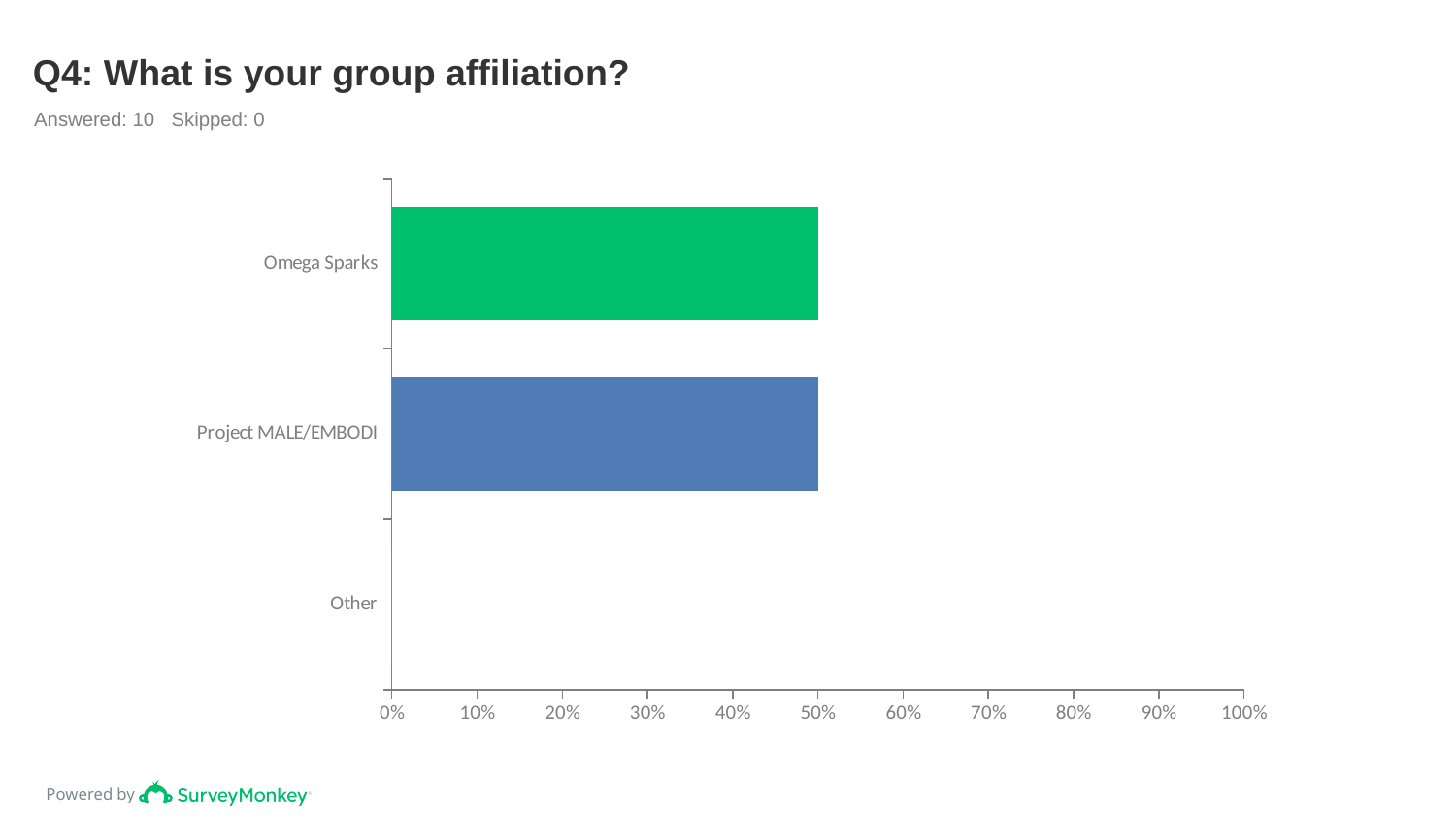
How many categories are shown on the chart? 3 Which is larger, the value for Omega Sparks or the value for Other? Omega Sparks Which category has the lowest value? Other What is the value for Omega Sparks? 50% What is the title of the chart? Q4: What is your group affiliation? Is the value for Project MALE/EMBODI greater or less than 40%? greater What is the difference between the values for Omega Sparks and Other? 50% What is the value for Other? 0% What kind of chart is shown on the slide? Bar chart What colour is the bar for Omega Sparks? Green Is the value for Omega Sparks greater or less than 60%? less What is the value for Project MALE/EMBODI? 50%